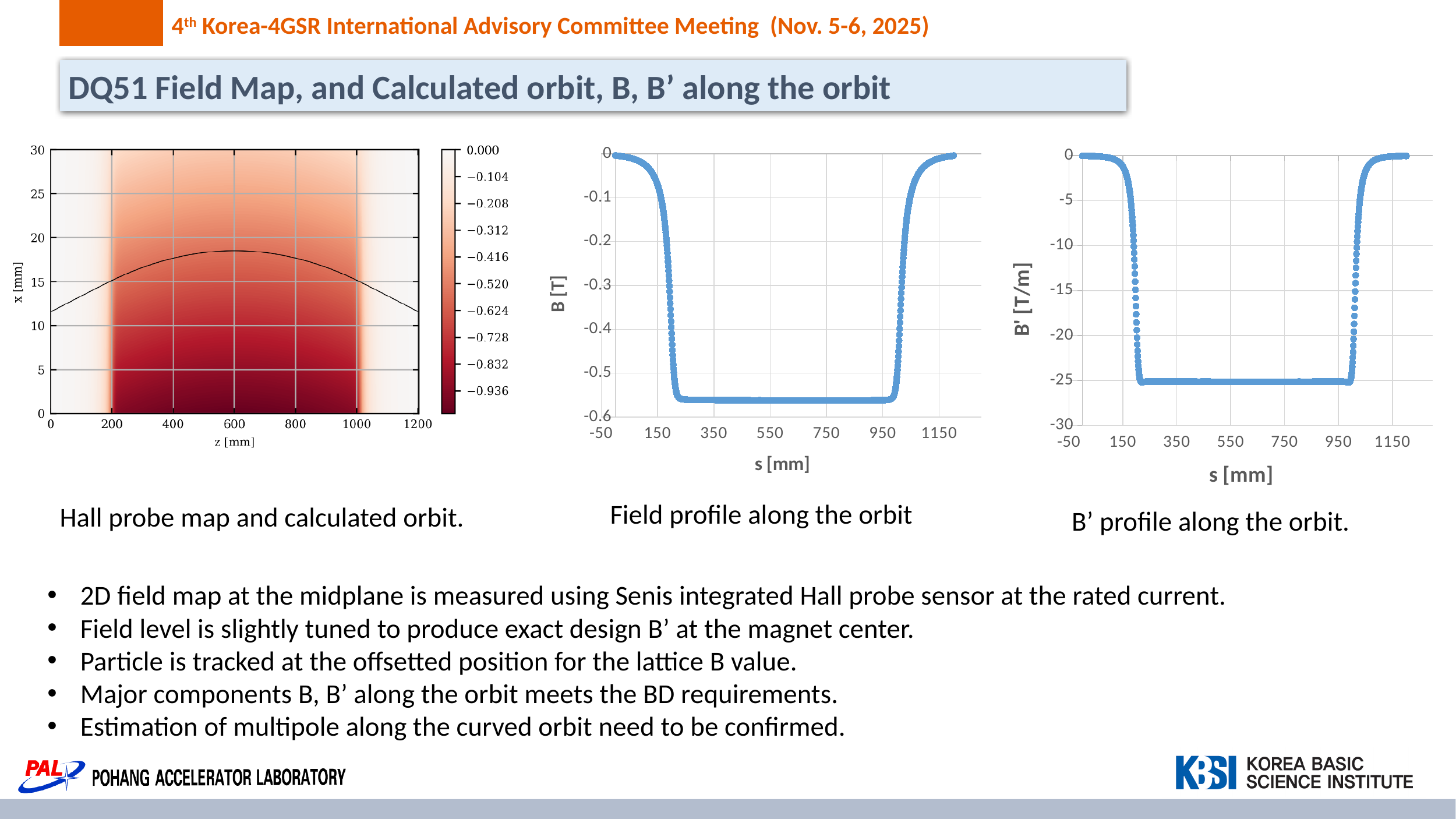
How many charts are shown on the slide? 3 In the 'Field profile along the orbit' chart, is the value of B at s = 0 mm greater or less than -0.1? greater In the 'B' profile along the orbit' chart, what is the label of the y axis? B' [T/m] In the 'B' profile along the orbit' chart, is the value of B' at s = 1150 mm greater or less than -5? greater In the 'Hall probe map and calculated orbit' chart, what is the lowest value shown on the colour bar? -0.936 In the 'B' profile along the orbit' chart, is the value of B' at s = 550 mm greater or less than -20? less In the 'B' profile along the orbit' chart, does B' rise or fall as s increases from 950 mm to 1150 mm? rise In the 'Field profile along the orbit' chart, does B rise or fall as s increases from -50 mm to 150 mm? fall In the 'Field profile along the orbit' chart, what is the label of the y axis? B [T] What kind of chart is the 'Field profile along the orbit' chart? scatter plot